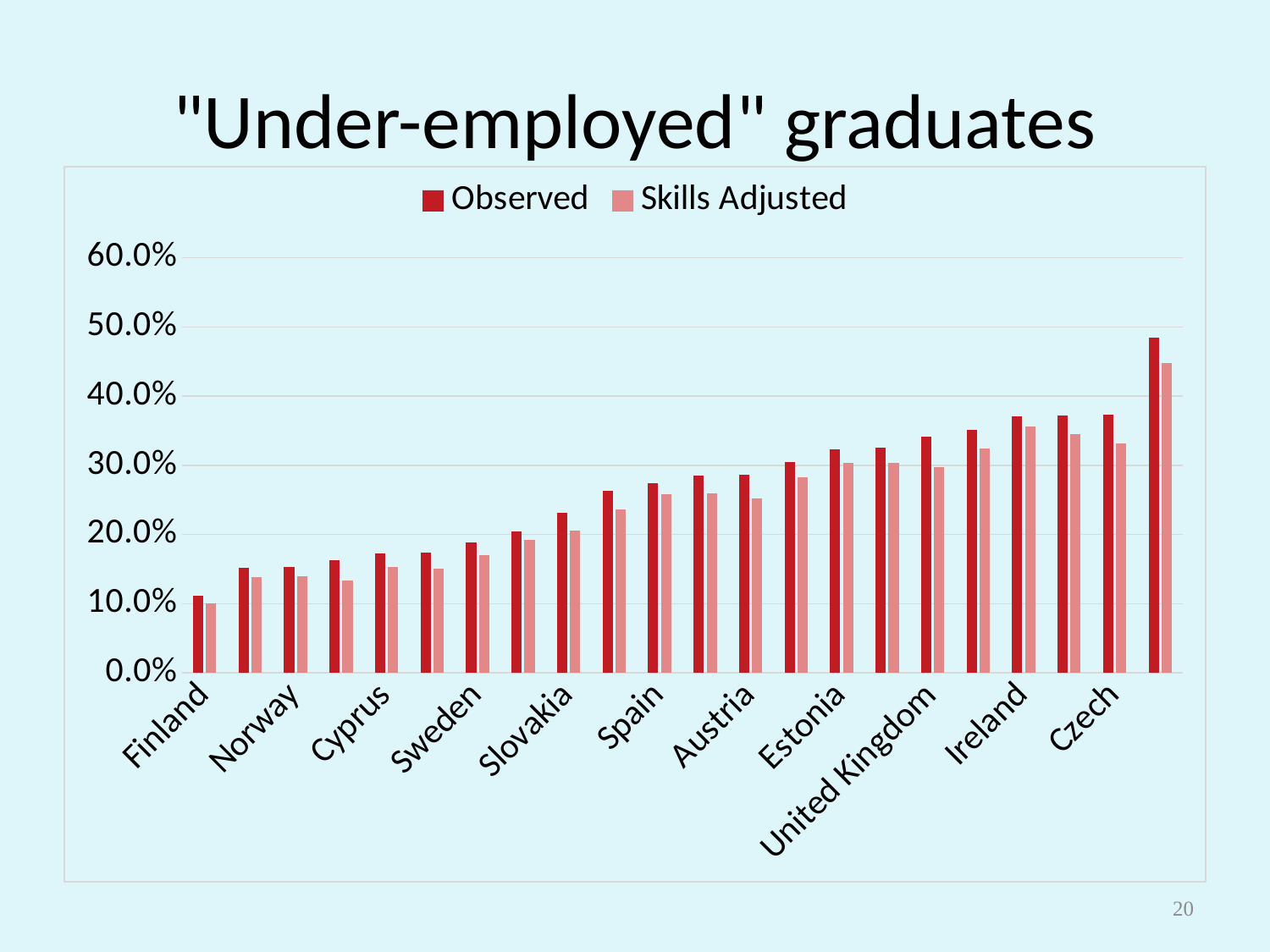
Which has the larger Observed value, Finland or Czech? Czech Is the Observed value for Ireland greater or less than 30.0%? greater Is the Observed value for Finland greater or less than 20.0%? less What is the title of the chart? "Under-employed" graduates Is the Observed value for Slovakia greater or less than 30.0%? less Do the Observed values generally rise or fall from left to right along the x axis? rise What kind of chart is shown on the slide? bar chart How many series does the legend list? 2 Which has the larger Skills Adjusted value, Spain or Norway? Spain What are the two series named in the legend? Observed and Skills Adjusted